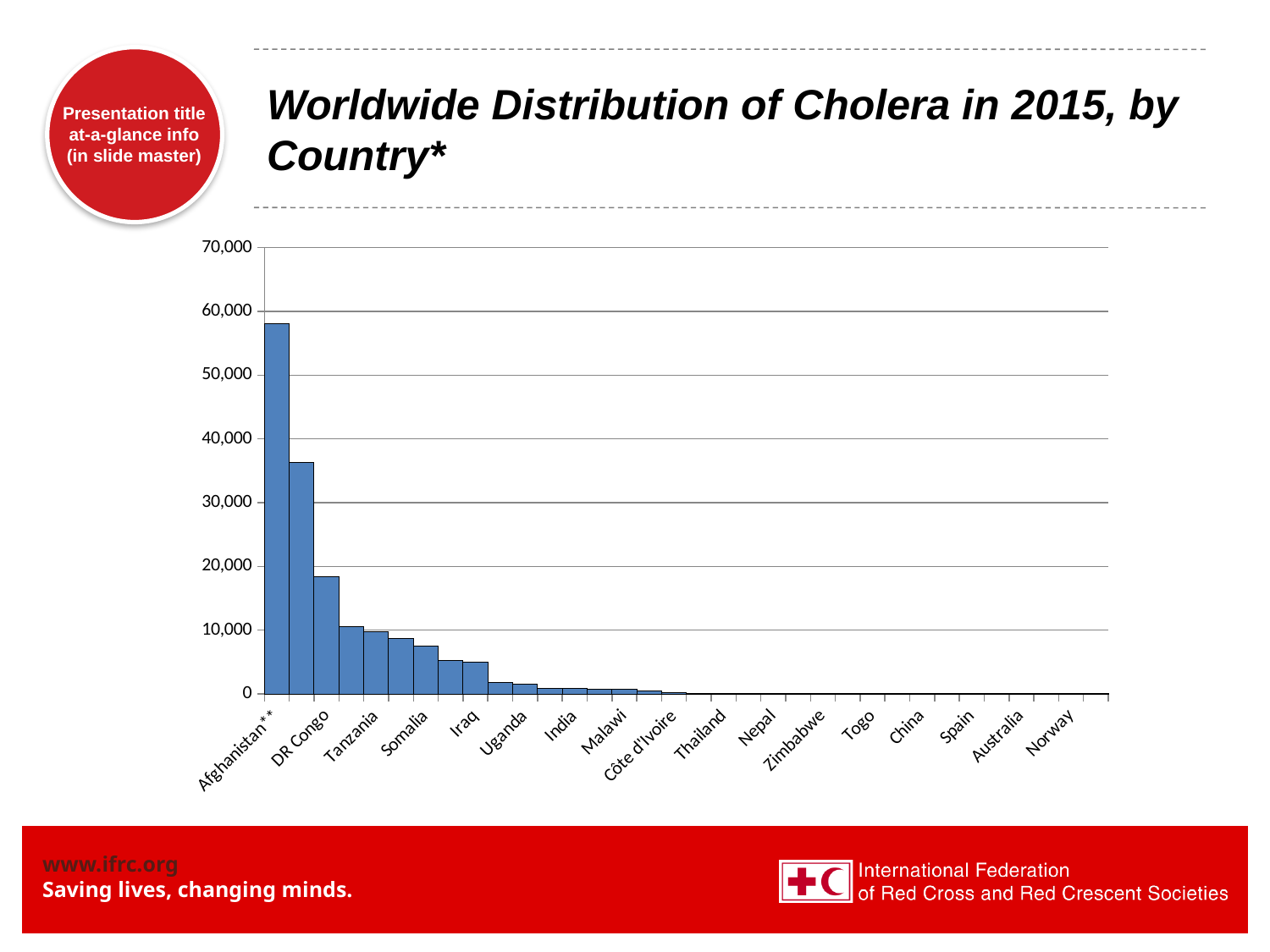
Is the value for DR Congo greater or less than 20,000? less Is the value for Somalia greater or less than 10,000? less Which country has the highest value in the chart? Afghanistan** What is the highest value shown on the vertical axis? 70,000 What kind of chart is shown on the slide? bar chart Is the value for DR Congo greater or less than 10,000? greater Which has a larger value, Afghanistan** or DR Congo? Afghanistan** What is the title of the chart on the slide? Worldwide Distribution of Cholera in 2015, by Country* Do the values rise or fall moving from left to right along the x axis? fall Which has a larger value, DR Congo or Iraq? DR Congo